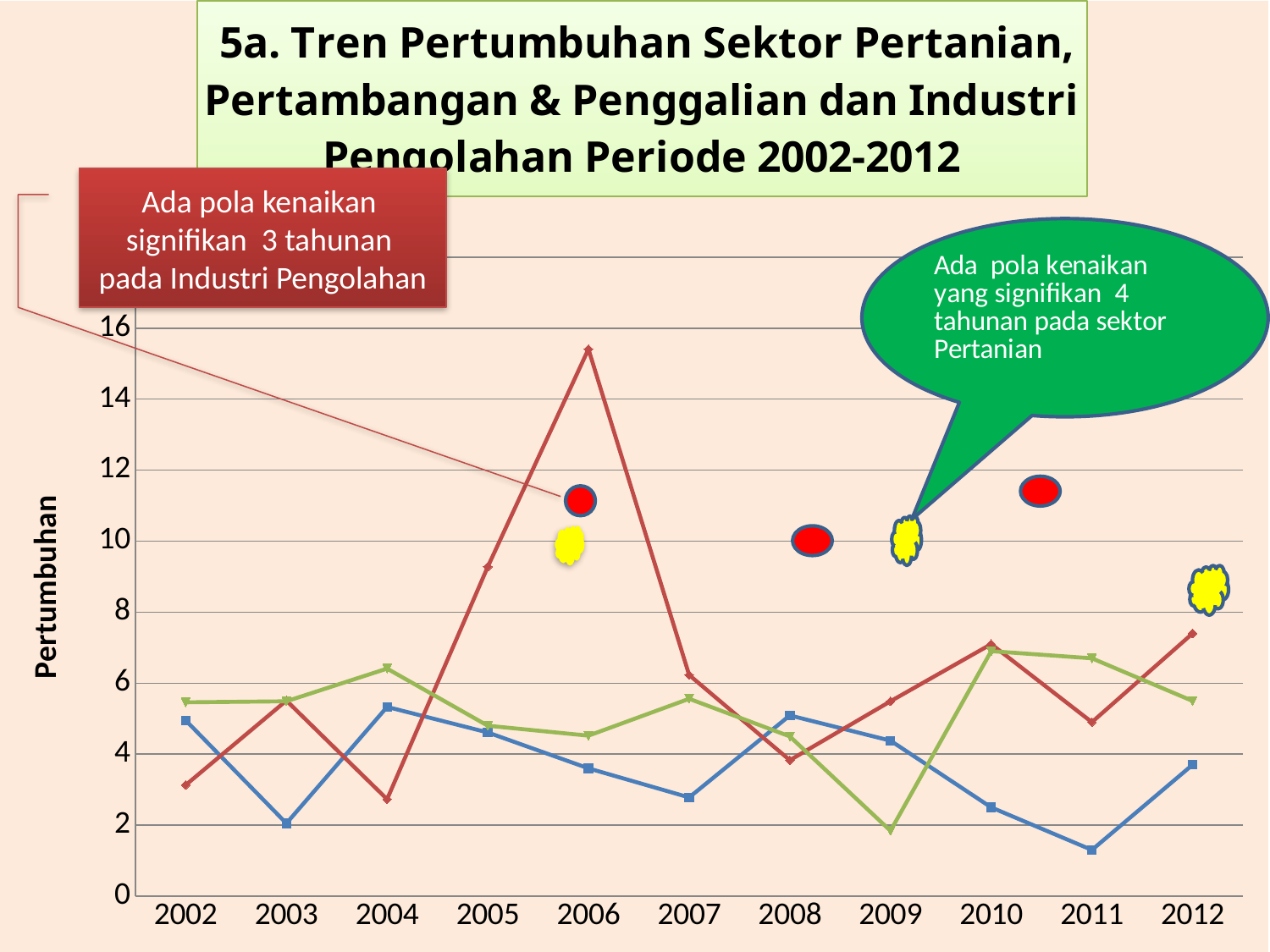
What period does the chart title say the data covers? 2002-2012 In which year does the blue line reach its lowest value? 2011 Is the value of the red line in 2012 greater or less than 6? greater In 2009, which line has the larger value, the green line or the blue line? blue line In which year does the red line reach its highest value? 2006 What is the label of the vertical axis? Pertumbuhan Is the value of the blue line in 2011 greater or less than 2? less In 2006, which line has the larger value, the red line or the blue line? red line Is the value of the red line in 2006 greater or less than 14? greater How many years are plotted along the x axis? 11 What kind of chart is shown on the slide? line chart